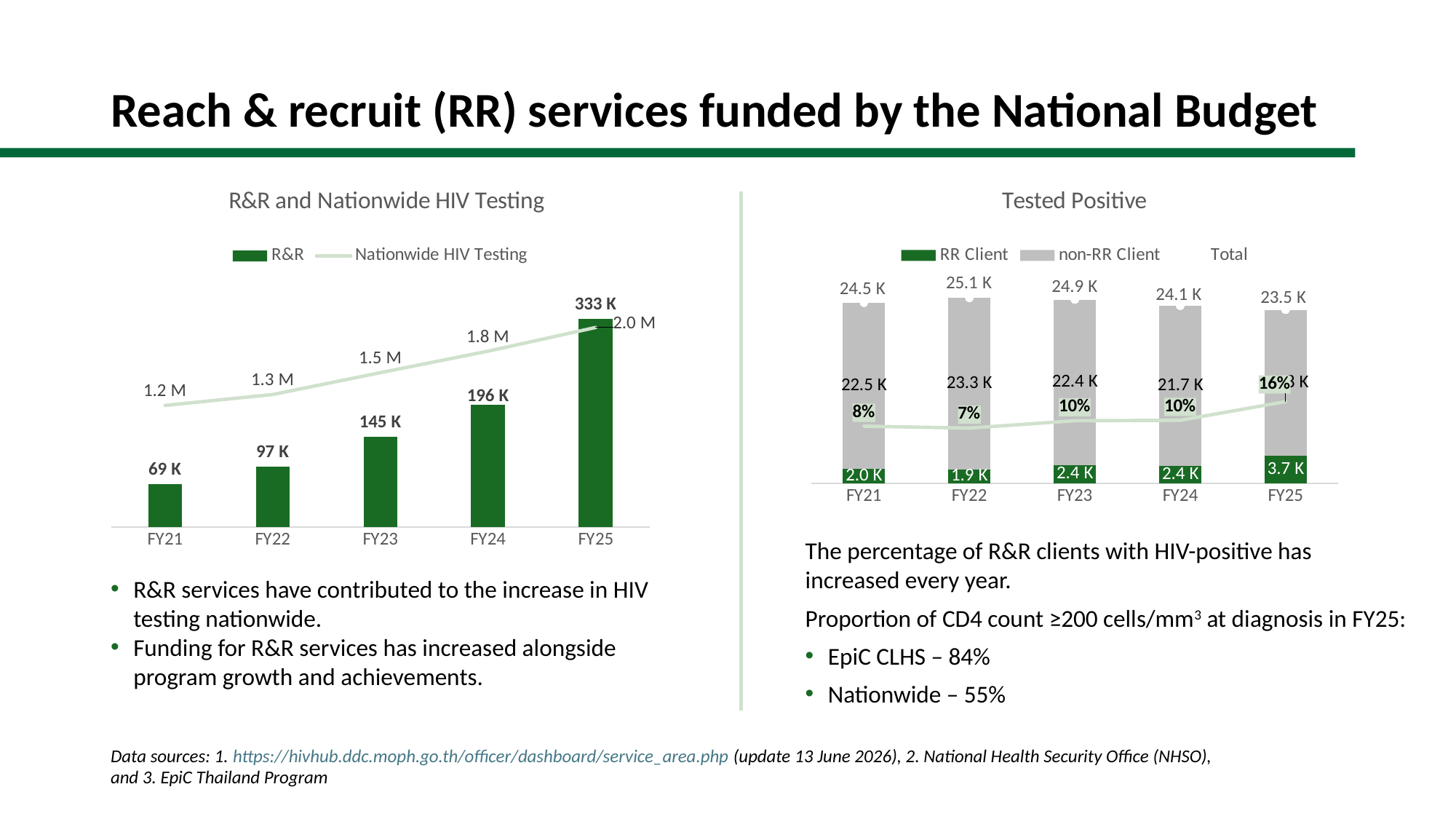
In the 'Tested Positive' chart, which fiscal year has the lowest Total? FY25 In the 'Tested Positive' chart, is the non-RR Client value for FY21 larger or smaller than for FY22? smaller In the 'R&R and Nationwide HIV Testing' chart, which fiscal year has the lowest R&R value? FY21 In the 'R&R and Nationwide HIV Testing' chart, what is the Nationwide HIV Testing value for FY25? 2.0 M In the 'Tested Positive' chart, what is the RR Client value for FY25? 3.7 K In the 'R&R and Nationwide HIV Testing' chart, does the Nationwide HIV Testing line rise or fall from FY21 to FY25? rise How many series does the legend of the 'R&R and Nationwide HIV Testing' chart list? 2 In the 'R&R and Nationwide HIV Testing' chart, what is the difference between the R&R values for FY25 and FY24? 137 K In the 'Tested Positive' chart, what is the Total for FY22? 25.1 K In the 'R&R and Nationwide HIV Testing' chart, what is the R&R value for FY23? 145 K In the 'R&R and Nationwide HIV Testing' chart, which fiscal year has the highest R&R value? FY25 In the 'Tested Positive' chart, what percentage is shown for FY23? 10%